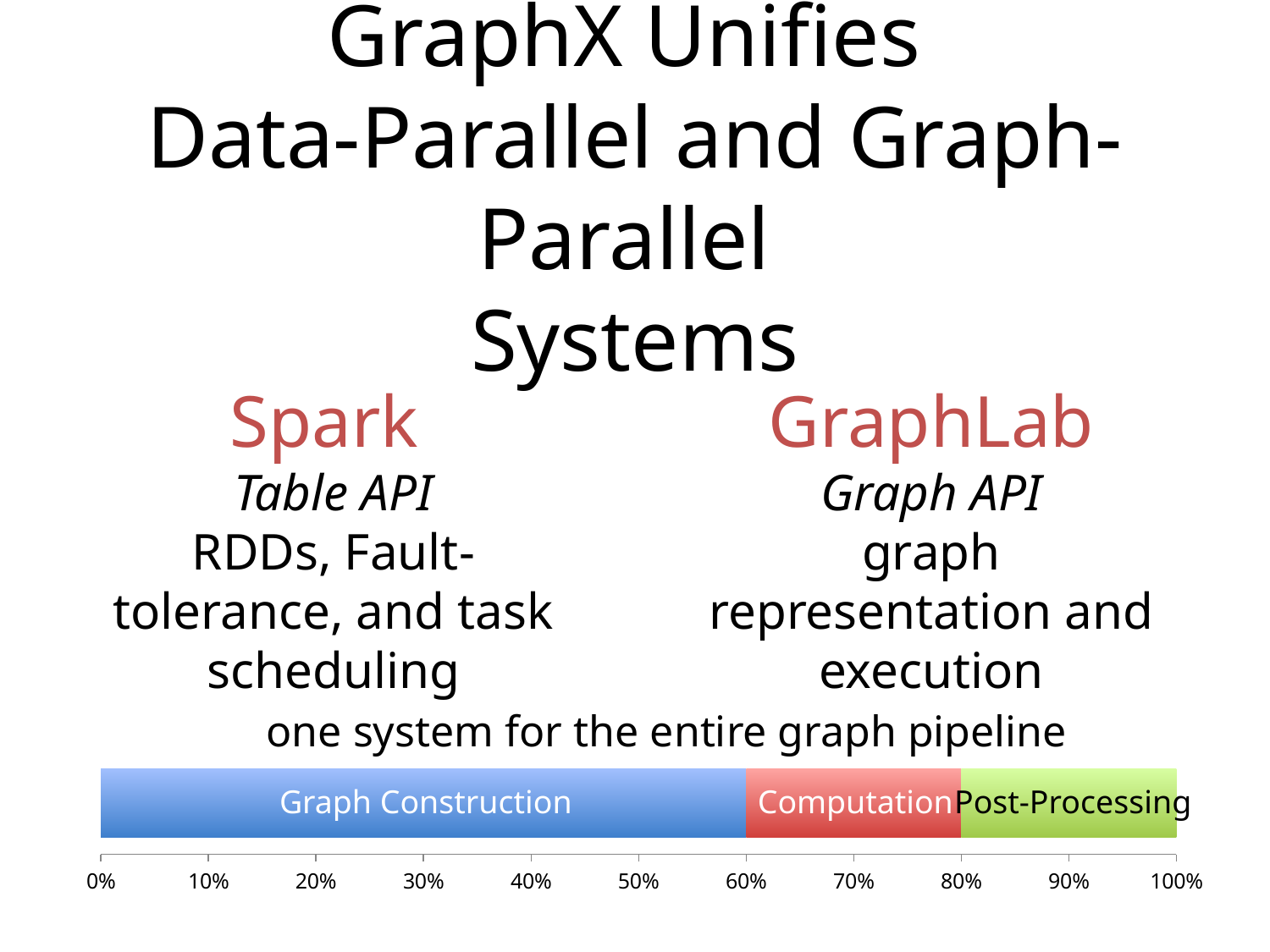
What kind of chart is shown at the bottom of the slide? bar chart At what percentage on the axis does the Graph Construction segment end? 60% At what percentage on the axis does the Computation segment end? 80% Which segment is larger, Graph Construction or Post-Processing? Graph Construction How many segments make up the stacked bar on the slide? 3 What is the highest value labelled on the horizontal axis? 100% Which segment of the stacked bar is the largest? Graph Construction Is the share of the bar taken by Computation greater or less than 30%? less Which segment of the bar is shown in green? Post-Processing What colour is the Computation segment of the bar? red What is the total of the stacked bar as shown on the axis? 100% Is the share of the bar taken by Graph Construction greater or less than 50%? greater